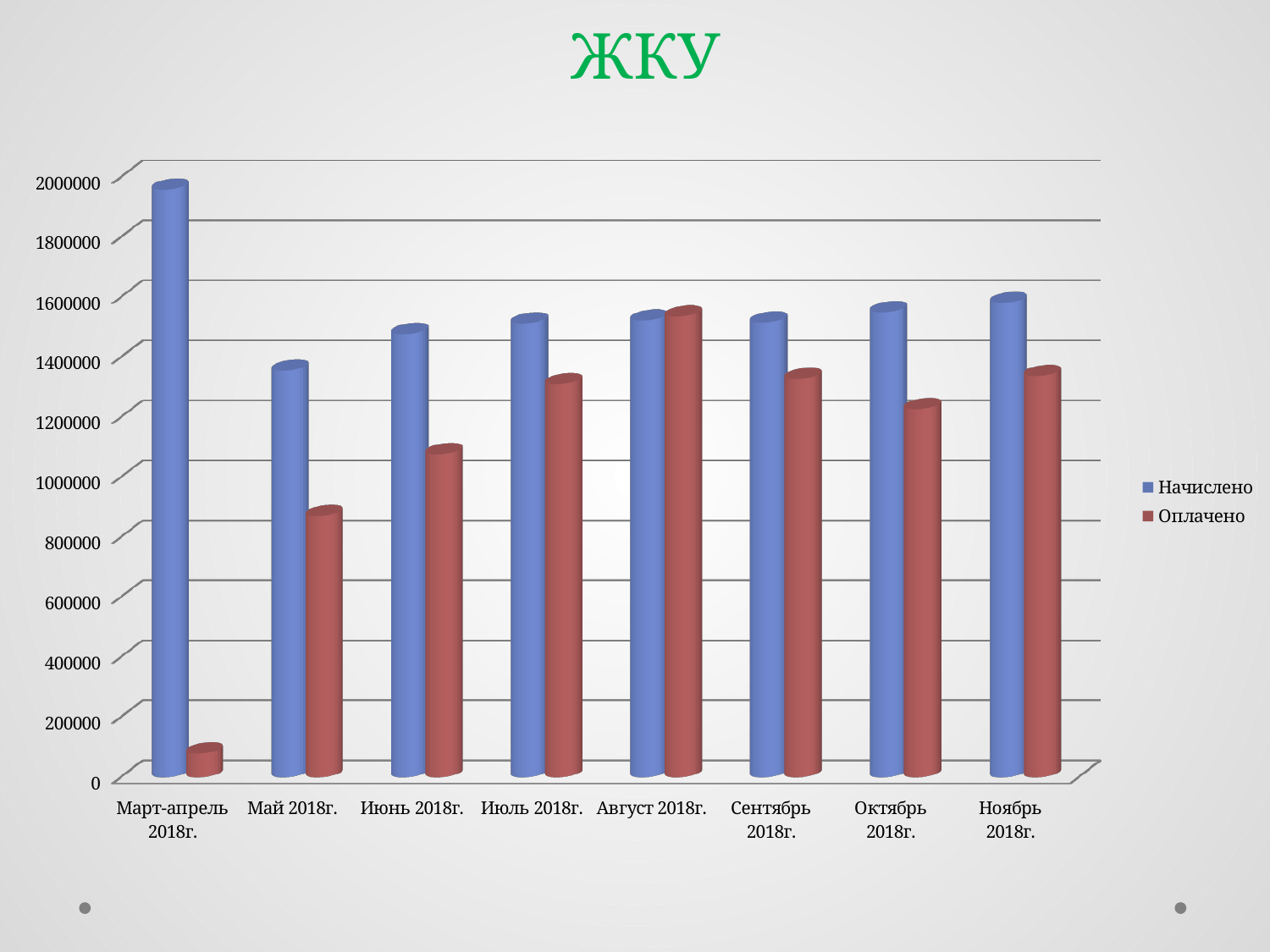
What is the title of the chart? ЖКУ From Май 2018г. to Ноябрь 2018г., do the Начислено values generally rise or fall? rise How many series does the legend list? 2 Is the value for Начислено in Март-апрель 2018г. greater or less than 1800000? greater How many categories are shown on the x axis? 8 Is the value for Оплачено in Май 2018г. greater or less than 1000000? less Which category has the lowest value for Оплачено? Март-апрель 2018г. Which category has the highest value for Оплачено? Август 2018г. In Октябрь 2018г., which is larger, Начислено or Оплачено? Начислено Which category has the lowest value for Начислено? Май 2018г. What kind of chart is shown on the slide? bar chart Which category has the highest value for Начислено? Март-апрель 2018г.